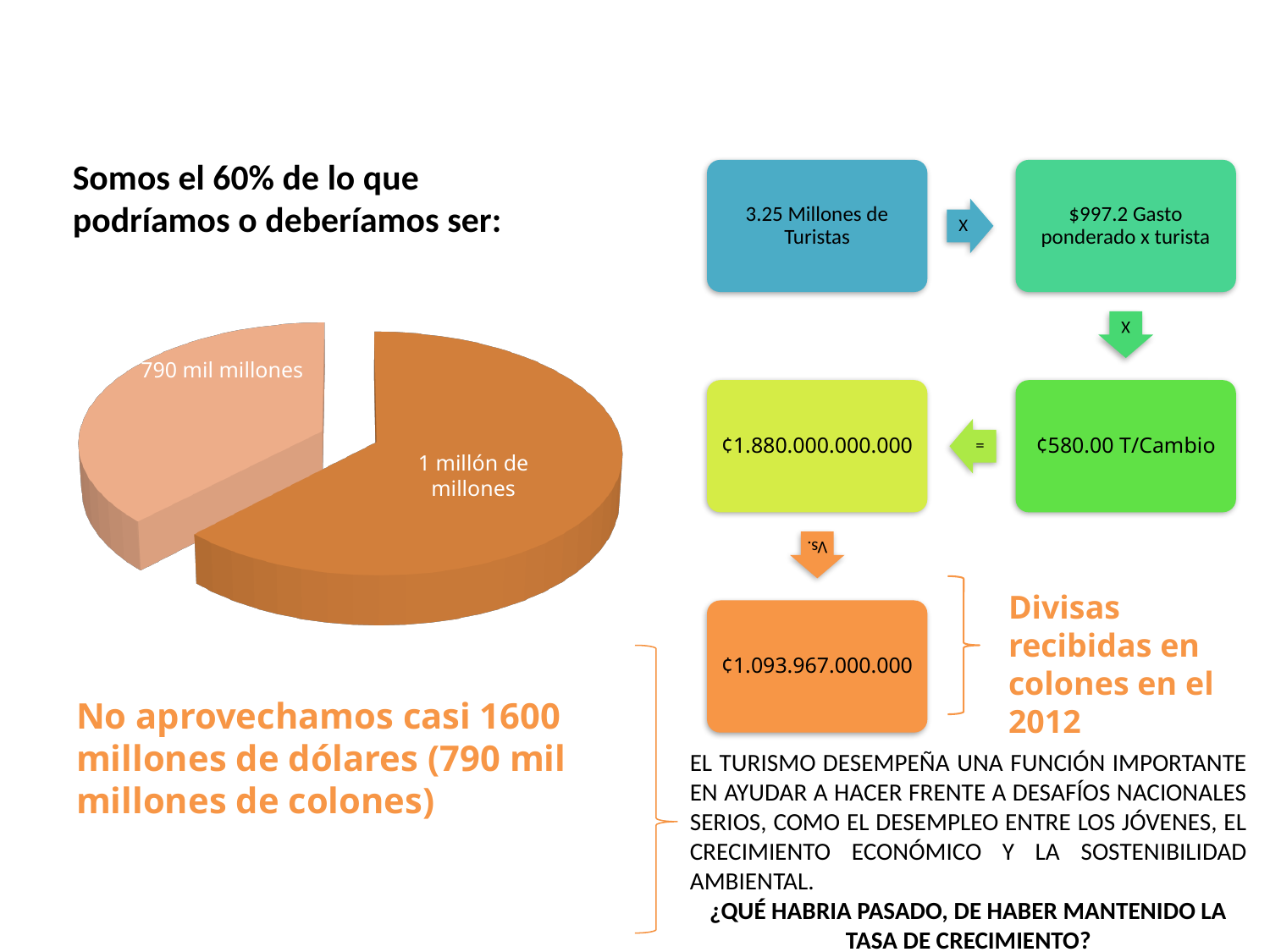
By how much does the '1 millón de millones' slice exceed the '790 mil millones' slice, in mil millones? 210 mil millones What is the label of the larger slice of the pie chart? 1 millón de millones Which slice of the pie chart is larger: '790 mil millones' or '1 millón de millones'? 1 millón de millones What value is shown on the light-coloured (peach) slice of the pie chart? 790 mil millones What kind of chart is shown on the left of the slide? Pie chart How many slices does the pie chart have? 2 What value is shown on the dark orange slice of the pie chart? 1 millón de millones Is the pie chart drawn in 3D or flat 2D? 3D Is the value of the smaller slice of the pie chart greater or less than 800 mil millones? less What is the label of the smaller slice of the pie chart? 790 mil millones Does the pie chart have a legend? No